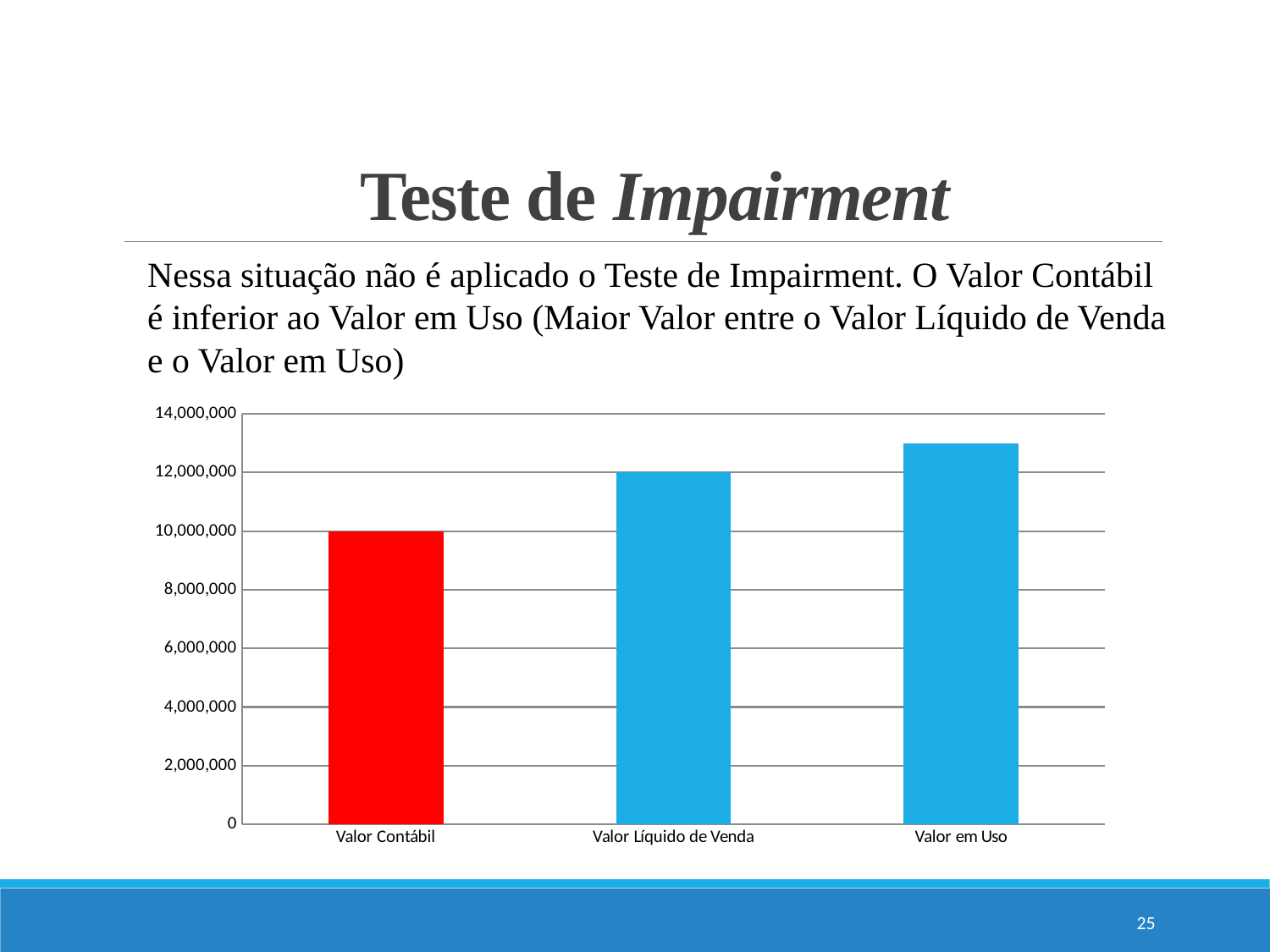
What is the value for Valor Líquido de Venda? 12,000,000 How many categories are shown on the x axis? 3 Is the value for Valor em Uso greater or less than 14,000,000? less Which category has the lowest value? Valor Contábil Which is larger, the value for Valor em Uso or the value for Valor Contábil? Valor em Uso What kind of chart is shown on the slide? bar chart Which category has the highest value? Valor em Uso What is the difference between the values for Valor Líquido de Venda and Valor Contábil? 2,000,000 Do the values rise or fall from left to right along the x axis? rise Is the value for Valor em Uso greater or less than 12,000,000? greater Which bar is coloured red? Valor Contábil What is the value for Valor Contábil? 10,000,000